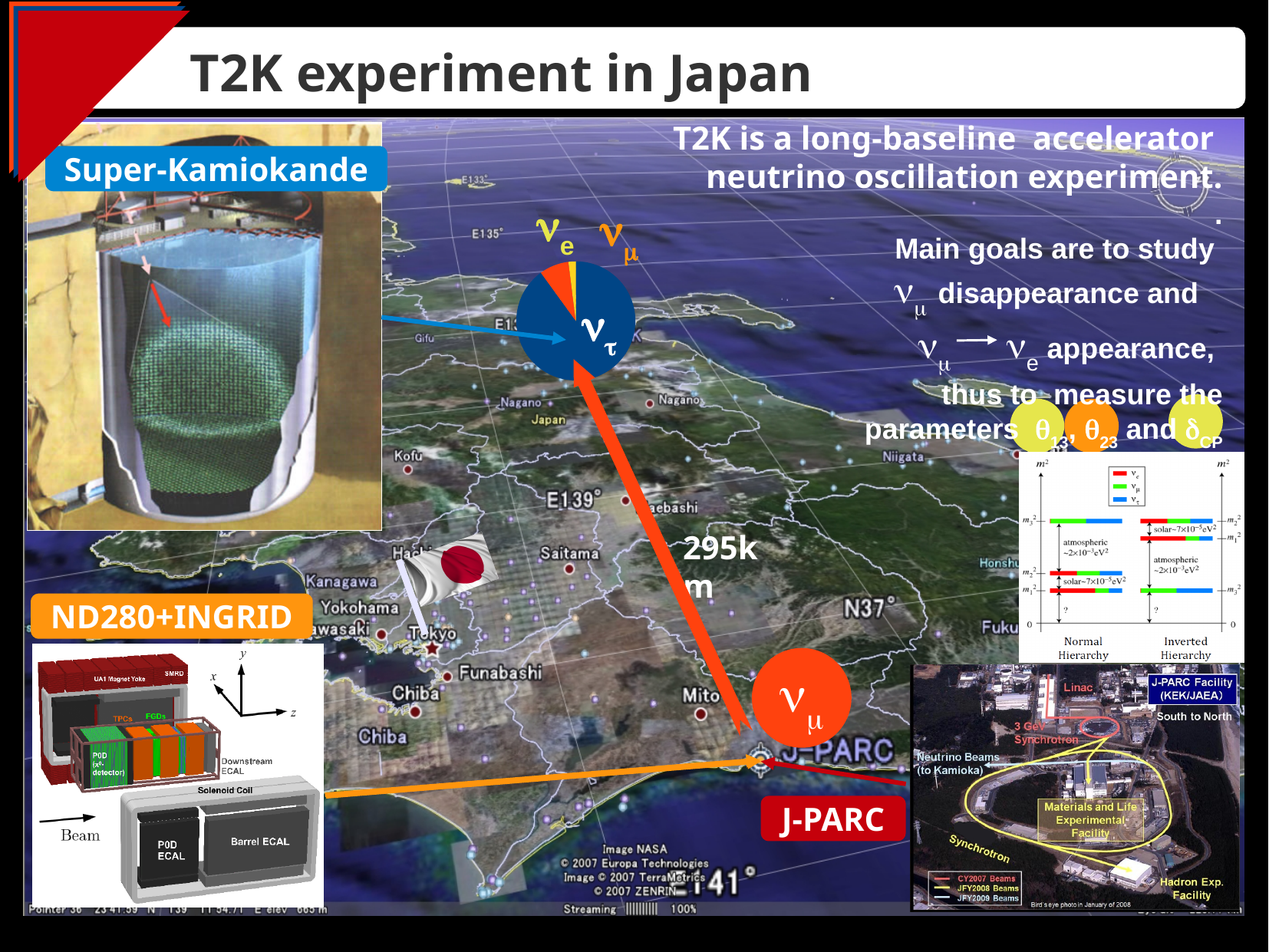
What are the two panels of the mass hierarchy diagram on the right of the slide labelled? Normal Hierarchy and Inverted Hierarchy How many entries does the legend of the mass hierarchy diagram on the right of the slide list? 3 Which neutrino flavour has the largest slice in the pie chart in the centre of the slide? ν_τ What colour is the ν_τ slice in the pie chart in the centre of the slide? dark blue In the pie chart in the centre of the slide, which slice is larger, ν_τ or ν_μ? ν_τ In the pie chart in the centre of the slide, which slice is larger, ν_μ or ν_e? ν_μ What kind of chart is the chart with the ν_τ label in the centre of the slide? pie chart Which neutrino flavour has the smallest slice in the pie chart in the centre of the slide? ν_e How many slices does the pie chart in the centre of the slide have? 3